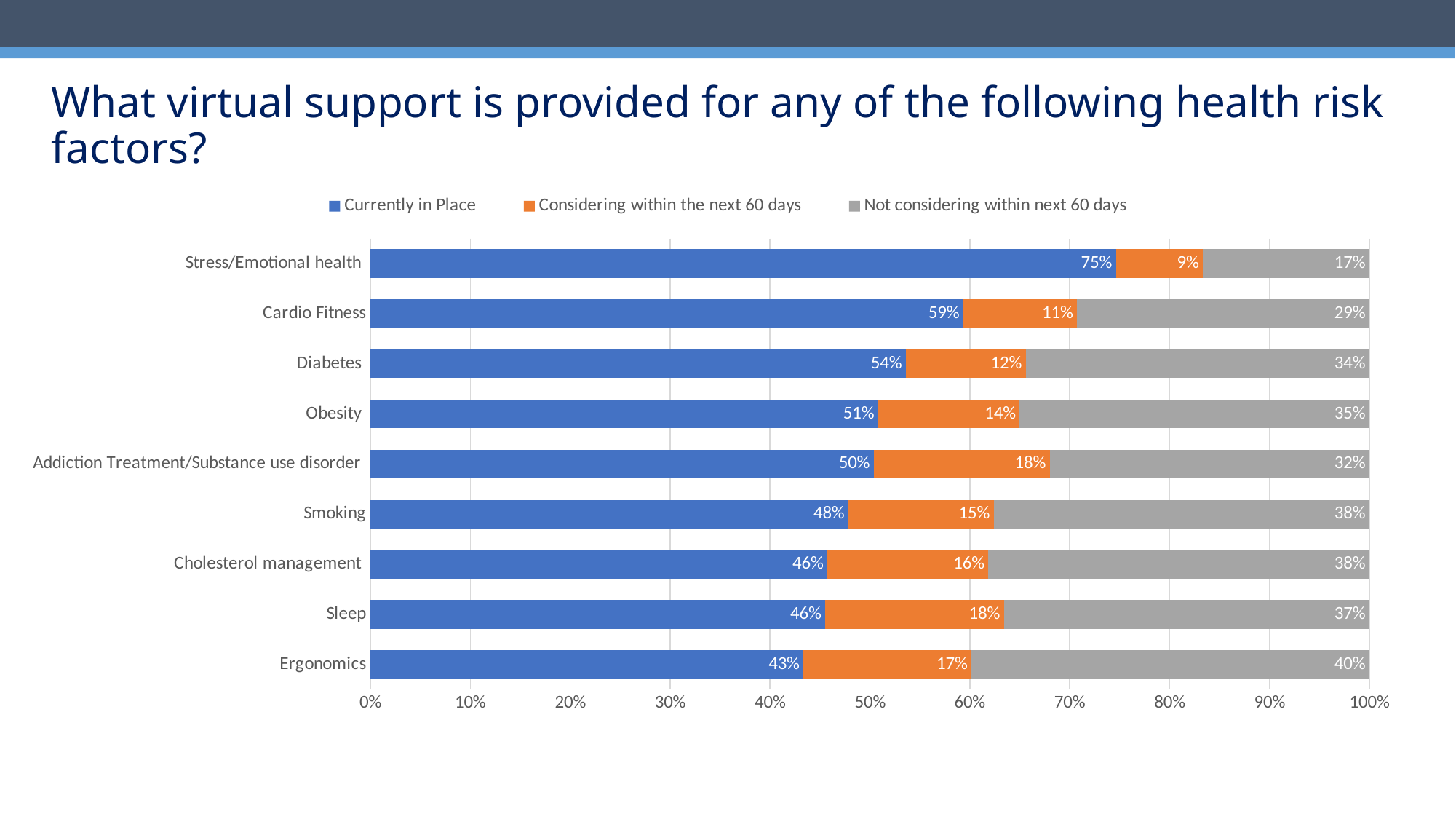
Which health risk factor has the highest 'Currently in Place' percentage? Stress/Emotional health Which health risk factor has the lowest 'Currently in Place' percentage? Ergonomics How many series does the legend list? 3 Which has a larger 'Not considering within next 60 days' value, Diabetes or Obesity? Obesity What is the difference between the 'Currently in Place' values for Stress/Emotional health and Cardio Fitness? 16% What is the 'Considering within the next 60 days' value for Smoking? 15% What kind of chart is shown on the slide? Stacked bar chart Which colour represents the 'Currently in Place' series? Blue What is the 'Not considering within next 60 days' value for Ergonomics? 40% What percentage of respondents currently have virtual support in place for Stress/Emotional health? 75% What is the 'Considering within the next 60 days' value for Addiction Treatment/Substance use disorder? 18% How many health risk factors are listed on the chart? 9